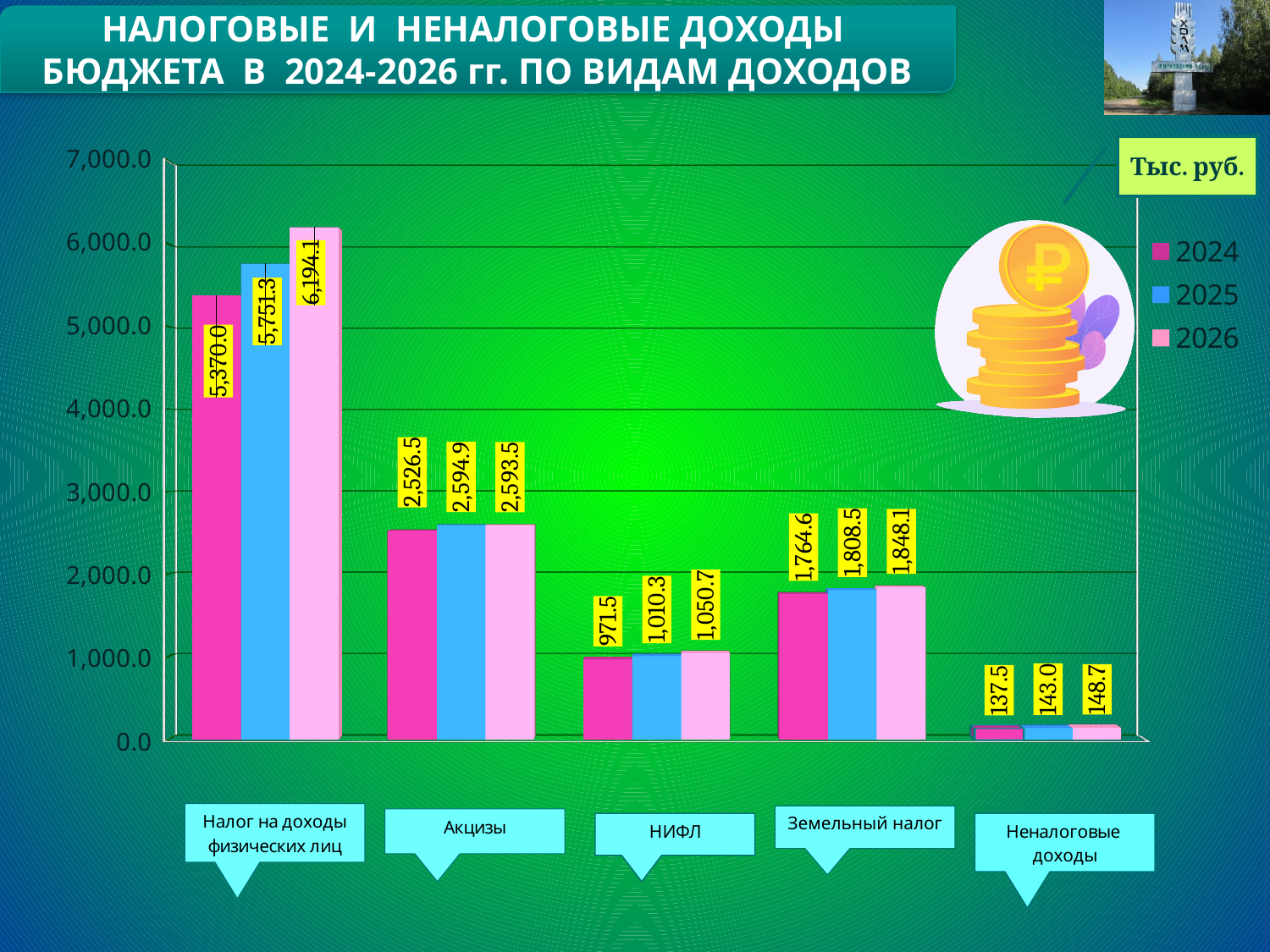
How many series does the legend list? 3 What is the 2026 value for Акцизы? 2,593.5 Which category has the highest value in 2026? Налог на доходы физических лиц What is the difference between the 2026 and 2024 values for Налог на доходы физических лиц? 824.1 What is the 2025 value for НИФЛ? 1,010.3 What is the 2024 value for Налог на доходы физических лиц? 5,370.0 Which is larger for Земельный налог: the 2024 value or the 2026 value? 2026 How many categories are shown on the x axis? 5 What kind of chart is shown on the slide? bar chart What unit is shown in the box at the top right of the chart? Тыс. руб. What is the 2026 value for Неналоговые доходы? 148.7 Which category has the lowest value in 2024? Неналоговые доходы